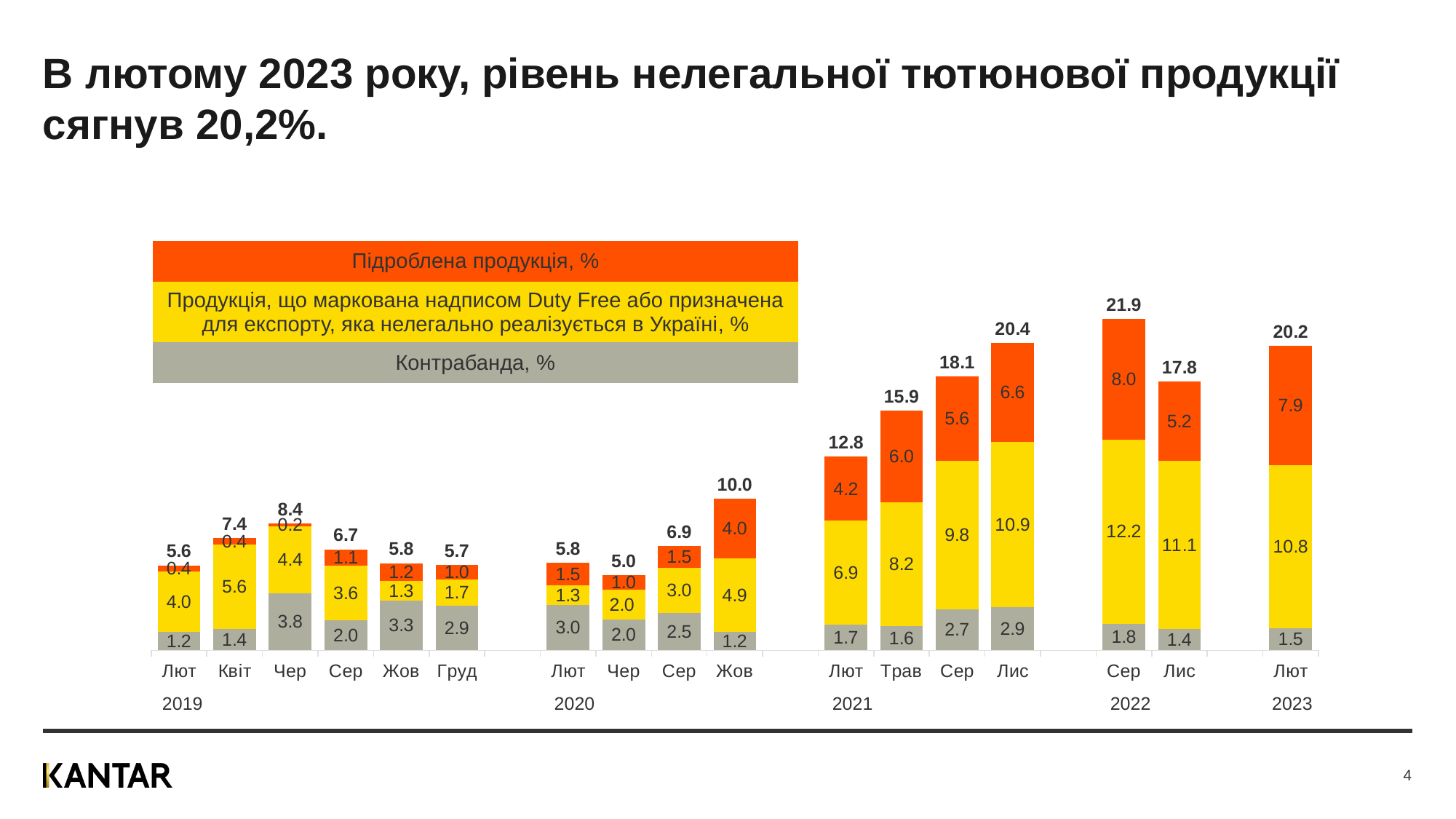
How many series does the legend list? 3 What is the value of the Duty Free / export series for Лис 2021? 10.9 Which bar has the highest total value? Сер 2022 How many bars are plotted in the chart? 17 Which is larger: the Підроблена продукція, % value for Лис 2021 or for Лис 2022? Лис 2021 What is the value of Підроблена продукція, % for Сер 2022? 8.0 What type of chart is shown on the slide? stacked bar chart What is the value of Контрабанда, % for Чер 2019? 3.8 What is the total value of the bar for Лют 2023? 20.2 Which colour represents Контрабанда, % in the chart? grey Which bar has the lowest total value? Чер 2020 What is the difference between the total for Сер 2022 and the total for Лис 2022? 4.1